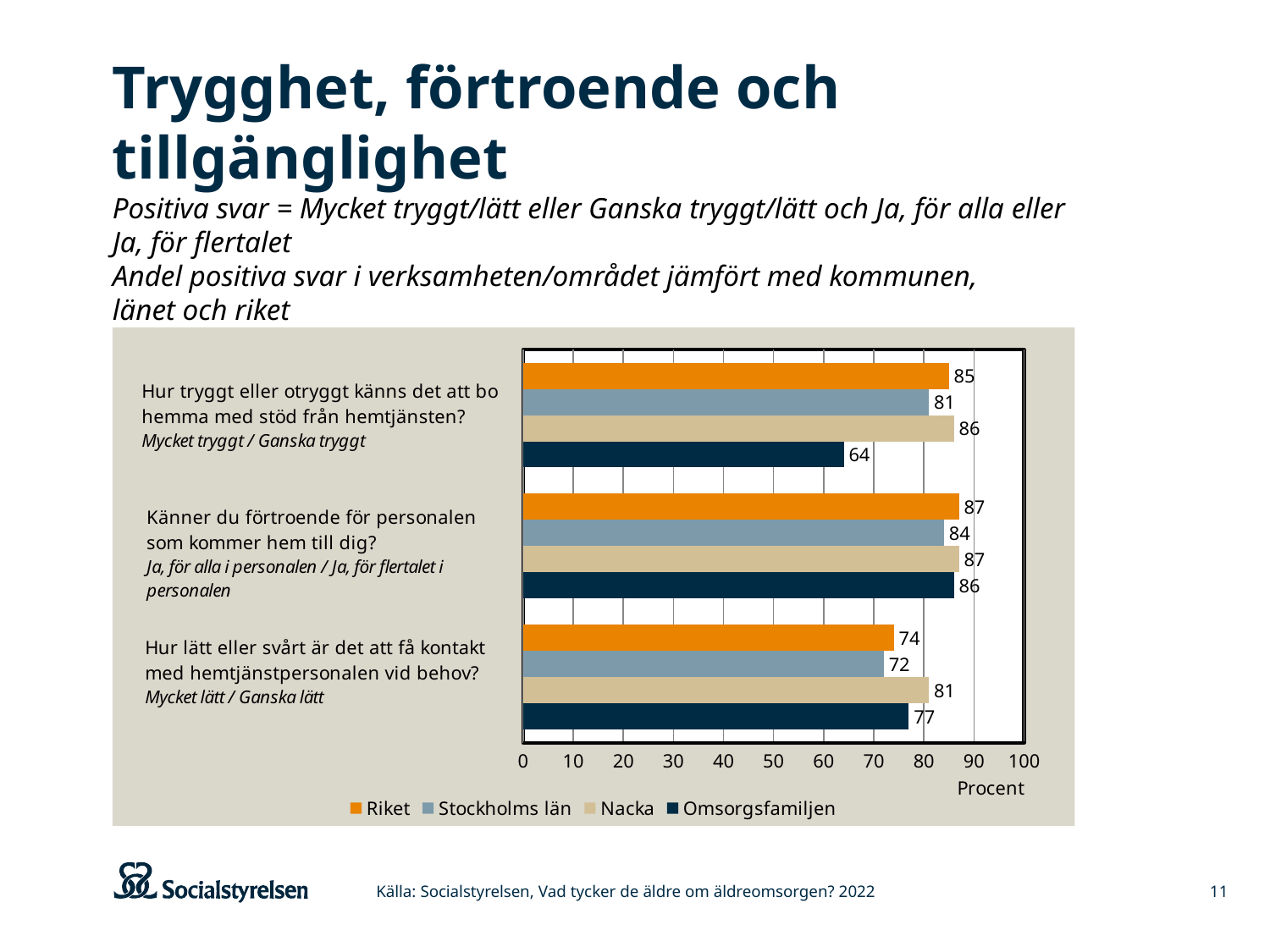
Which is larger on the question "Känner du förtroende för personalen som kommer hem till dig?": Omsorgsfamiljen or Stockholms län? Omsorgsfamiljen Which series has the lowest value on the question "Hur tryggt eller otryggt känns det att bo hemma med stöd från hemtjänsten?" Omsorgsfamiljen What is the value for Omsorgsfamiljen on the question "Hur tryggt eller otryggt känns det att bo hemma med stöd från hemtjänsten?" 64 What is the value for Stockholms län on the question "Känner du förtroende för personalen som kommer hem till dig?" 84 What is the label on the horizontal axis of the chart? Procent What is the difference between Riket and Stockholms län on the question "Hur lätt eller svårt är det att få kontakt med hemtjänstpersonalen vid behov?" 2 Which series has the highest value on the question "Hur lätt eller svårt är det att få kontakt med hemtjänstpersonalen vid behov?" Nacka How many series does the legend list? 4 How many question categories are shown on the chart? 3 What is the difference between Nacka and Omsorgsfamiljen on the question "Hur tryggt eller otryggt känns det att bo hemma med stöd från hemtjänsten?" 22 What kind of chart is shown on the slide? Bar chart What is the value for Nacka on the question "Hur lätt eller svårt är det att få kontakt med hemtjänstpersonalen vid behov?" 81